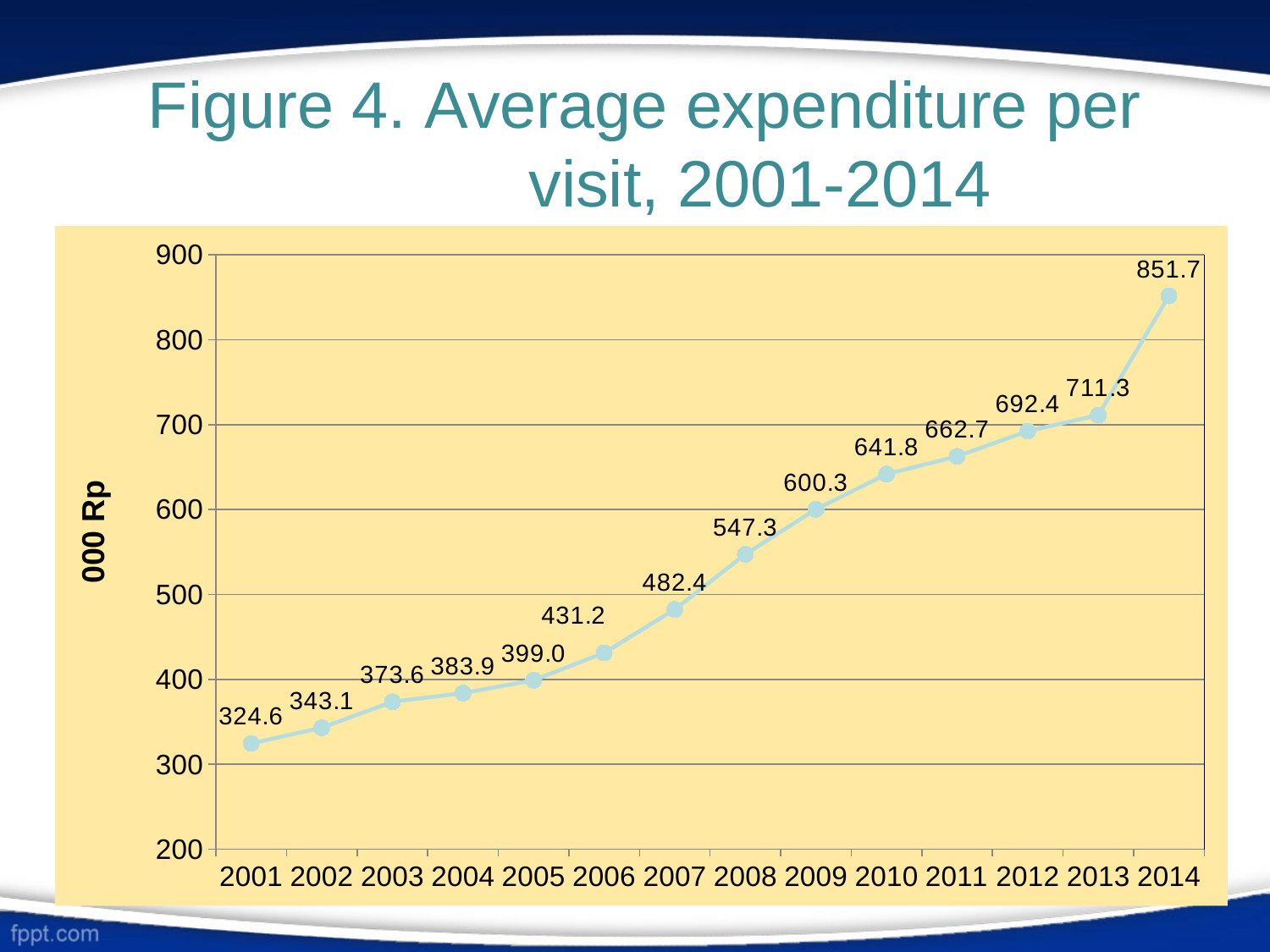
How many years are plotted on the chart? 14 What is the difference between the average expenditure per visit in 2009 and in 2008? 53.0 What is the average expenditure per visit in 2001? 324.6 What kind of chart is shown on the slide? line chart Which year has the lowest average expenditure per visit? 2001 Do the values rise or fall from 2001 to 2014? rise Which is larger, the average expenditure per visit in 2006 or in 2007? 2007 Which year has the highest average expenditure per visit? 2014 What is the difference between the average expenditure per visit in 2014 and in 2013? 140.4 What is the average expenditure per visit in 2008? 547.3 What is the average expenditure per visit in 2014? 851.7 Is the value for 2010 greater or less than 600? greater